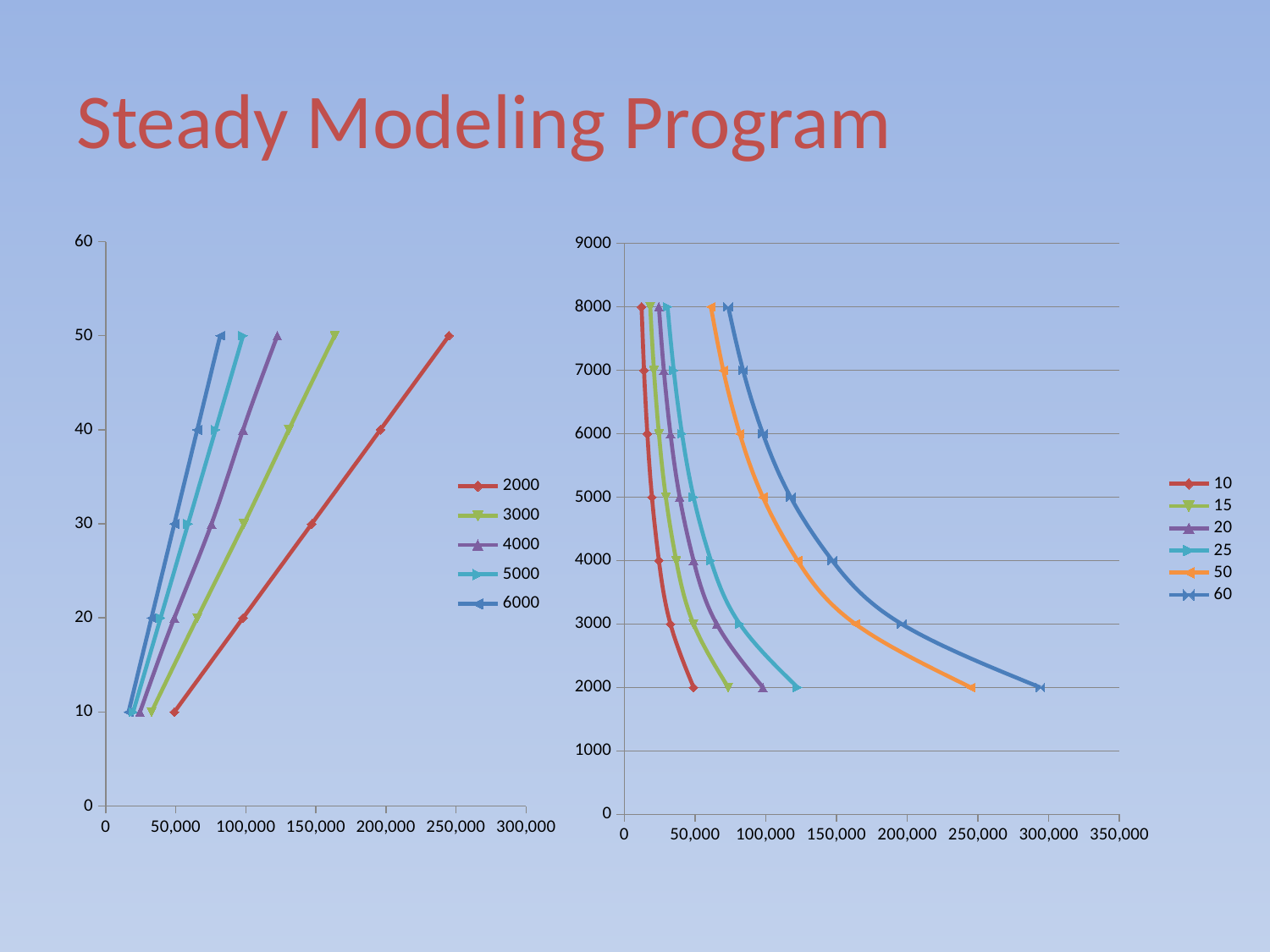
In the left chart, is the x value of the 2000 series at y = 50 greater or less than 200,000? greater In the right chart, is the x value of the 60 series at y = 2000 greater or less than 250,000? greater In the left chart, which series reaches the largest x value? 2000 How many series does the legend of the left chart list? 5 In the right chart, do the y values rise or fall as x increases along each series? fall In the left chart, is the x value of the 6000 series at y = 50 greater or less than 100,000? less What type of chart is the left chart on the slide? line chart How many series does the legend of the right chart list? 6 What is the title of the slide containing the two charts? Steady Modeling Program In the right chart, how many data points does the 60 series have? 7 In the left chart, how many data points does the 2000 series have? 5 In the right chart, at y = 2000, which series has the larger x value, 10 or 60? 60